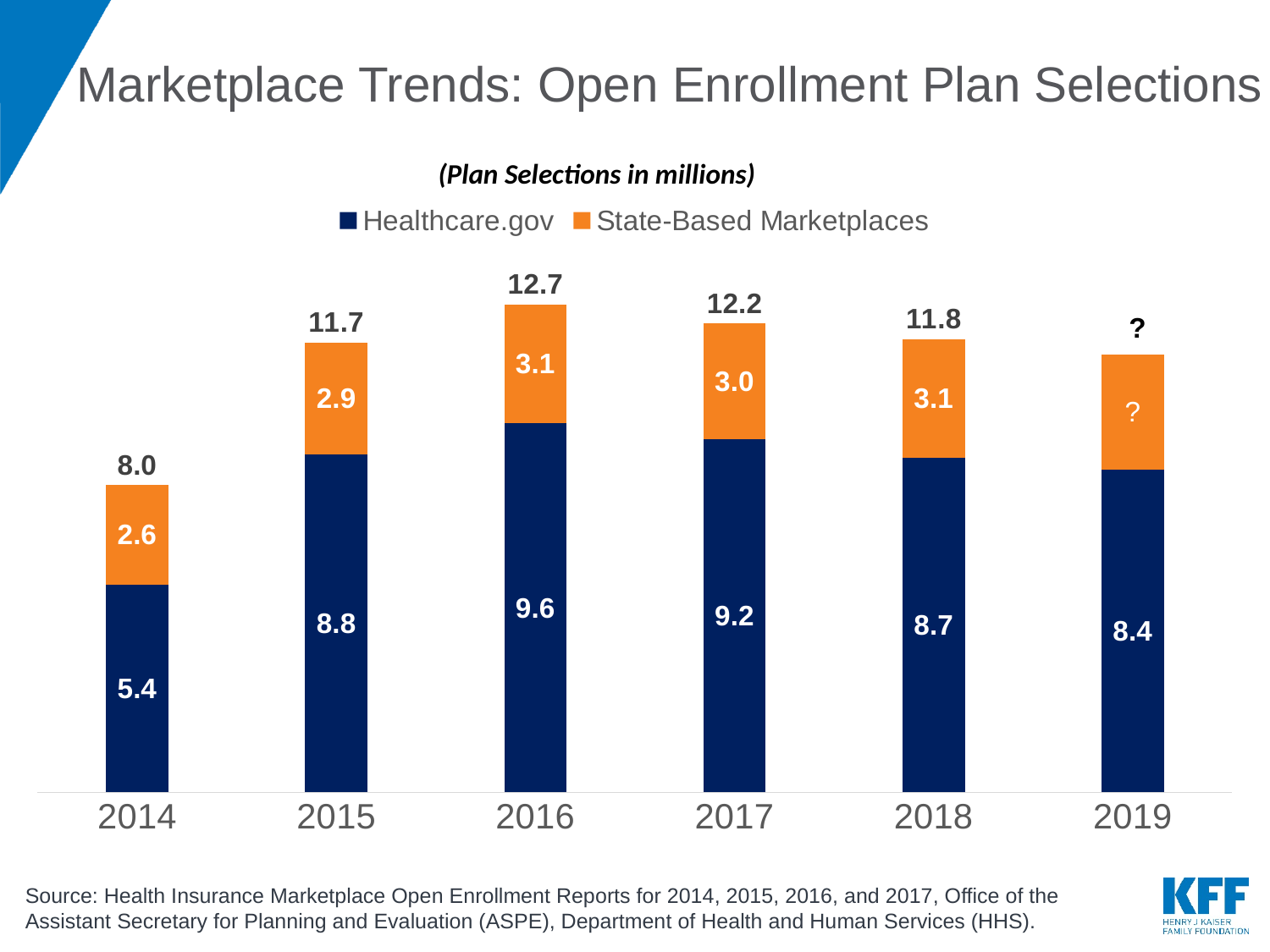
What is the difference between the Healthcare.gov values for 2016 and 2018? 0.9 What is the Healthcare.gov value for 2016? 9.6 What is the total plan selections shown for 2017? 12.2 What kind of chart is shown? Stacked bar chart What is the State-Based Marketplaces value for 2014? 2.6 Does the total plan selections rise or fall from 2016 to 2018? Fall Is the Healthcare.gov value larger in 2015 or in 2019? 2015 Which year has the highest total plan selections? 2016 How many years are shown on the x axis? 6 Which year has the lowest Healthcare.gov value? 2014 How many series does the legend list? 2 What label is shown for the State-Based Marketplaces value in 2019? ?